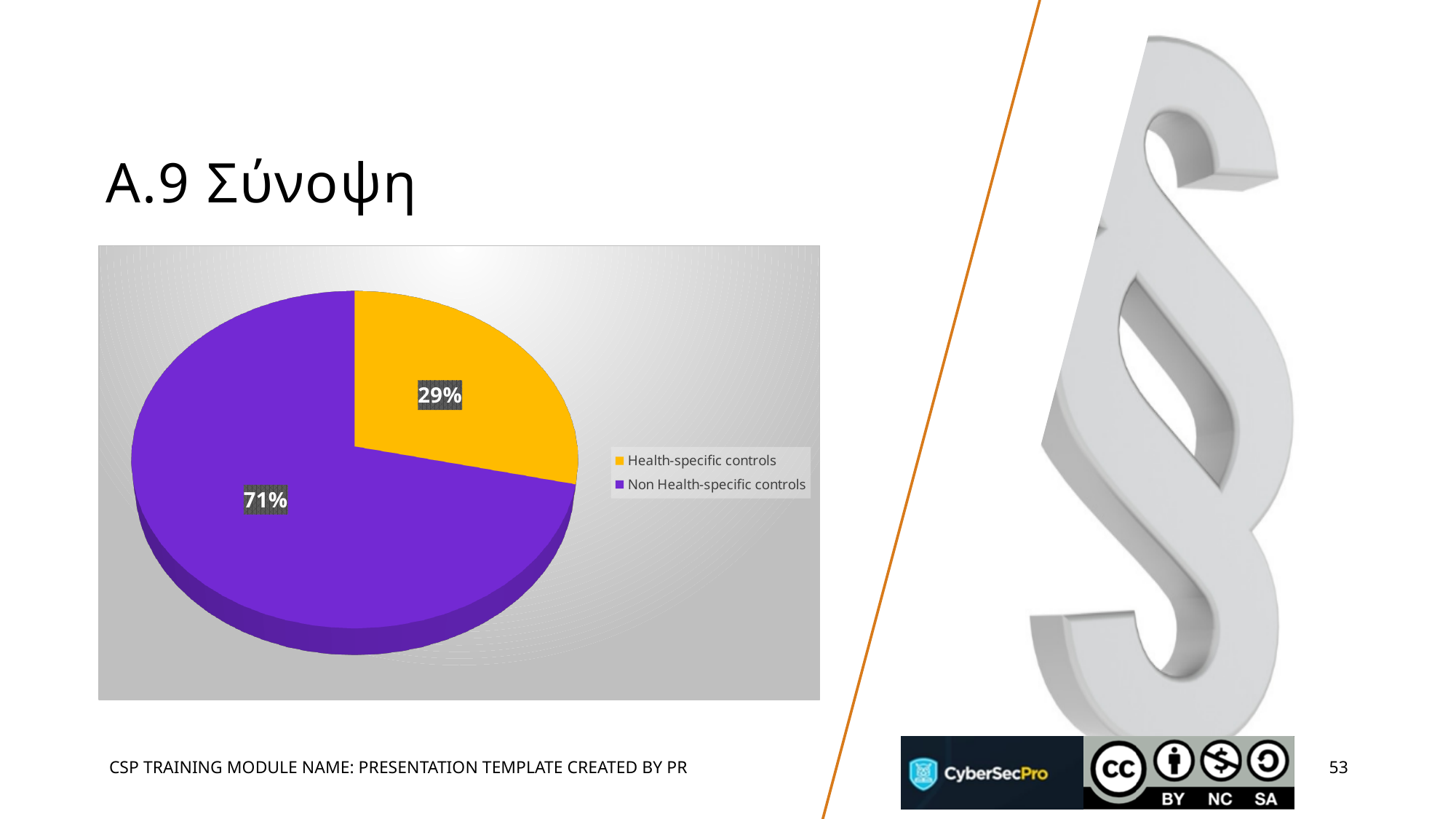
What colour is the slice for Health-specific controls? Yellow What colour is the slice for Non Health-specific controls? Purple Which category has the largest share of the pie? Non Health-specific controls What kind of chart is shown on the slide? Pie chart What percentage of the pie is Health-specific controls? 29% Which category has the smallest share of the pie? Health-specific controls What percentage of the pie is Non Health-specific controls? 71% Which is larger: the share for Health-specific controls or the share for Non Health-specific controls? Non Health-specific controls How many entries does the legend list? 2 What is the total of the two slice percentages shown on the pie chart? 100% How many slices does the pie chart have? 2 What is the difference in percentage points between Non Health-specific controls and Health-specific controls? 42